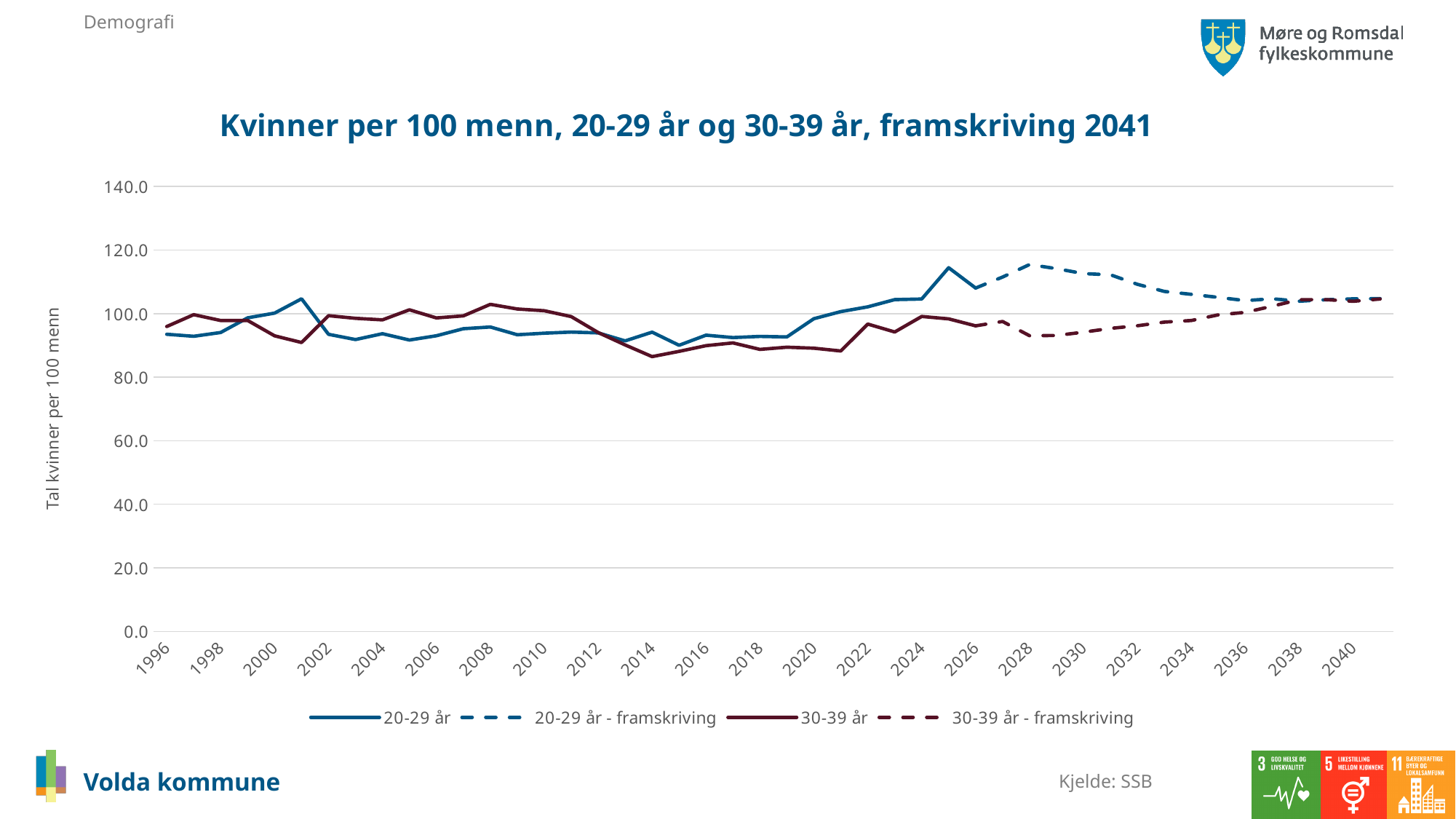
Does the 30-39 år - framskriving line rise or fall from 2028 to 2040? rise What is the label on the vertical axis? Tal kvinner per 100 menn Is the value for 20-29 år - framskriving in 2028 greater or less than 100? greater In 2025, which is larger: the value for 20-29 år or the value for 30-39 år? 20-29 år What kind of chart is shown on the slide? line chart In 2008, which is larger: the value for 20-29 år or the value for 30-39 år? 30-39 år Does the 20-29 år - framskriving line rise or fall from 2028 to 2040? fall What is the title of the chart? Kvinner per 100 menn, 20-29 år og 30-39 år, framskriving 2041 Is the value for 30-39 år in 2014 greater or less than 100? less How many series does the legend list? 4 Is the value for 20-29 år in 2025 greater or less than 100? greater